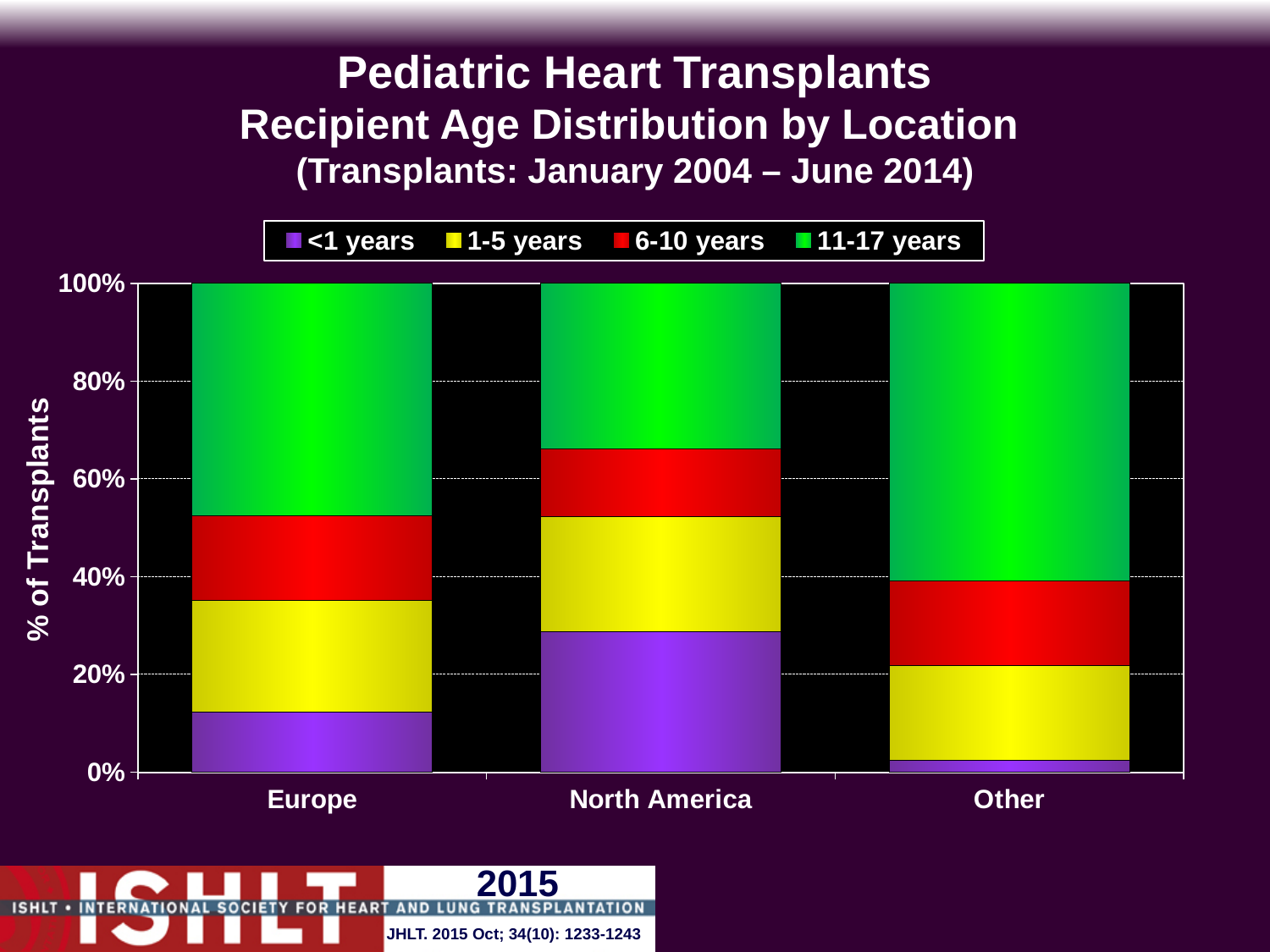
What is the label on the y axis? % of Transplants What kind of chart is shown on the slide? Stacked bar chart How many locations are shown on the x axis? 3 Which location has the smallest share of recipients aged <1 years? Other How many age groups does the legend list? 4 Is the share of recipients aged 11-17 years larger in Other or in North America? Other Is the share of recipients aged <1 years in North America greater or less than 20%? greater Which location has the largest share of recipients aged 11-17 years? Other Which location has the largest share of recipients aged <1 years? North America Is the share of recipients aged 11-17 years in Other greater or less than 40%? greater Is the share of recipients aged <1 years larger in North America or in Europe? North America Is the share of recipients aged <1 years in Europe greater or less than 20%? less